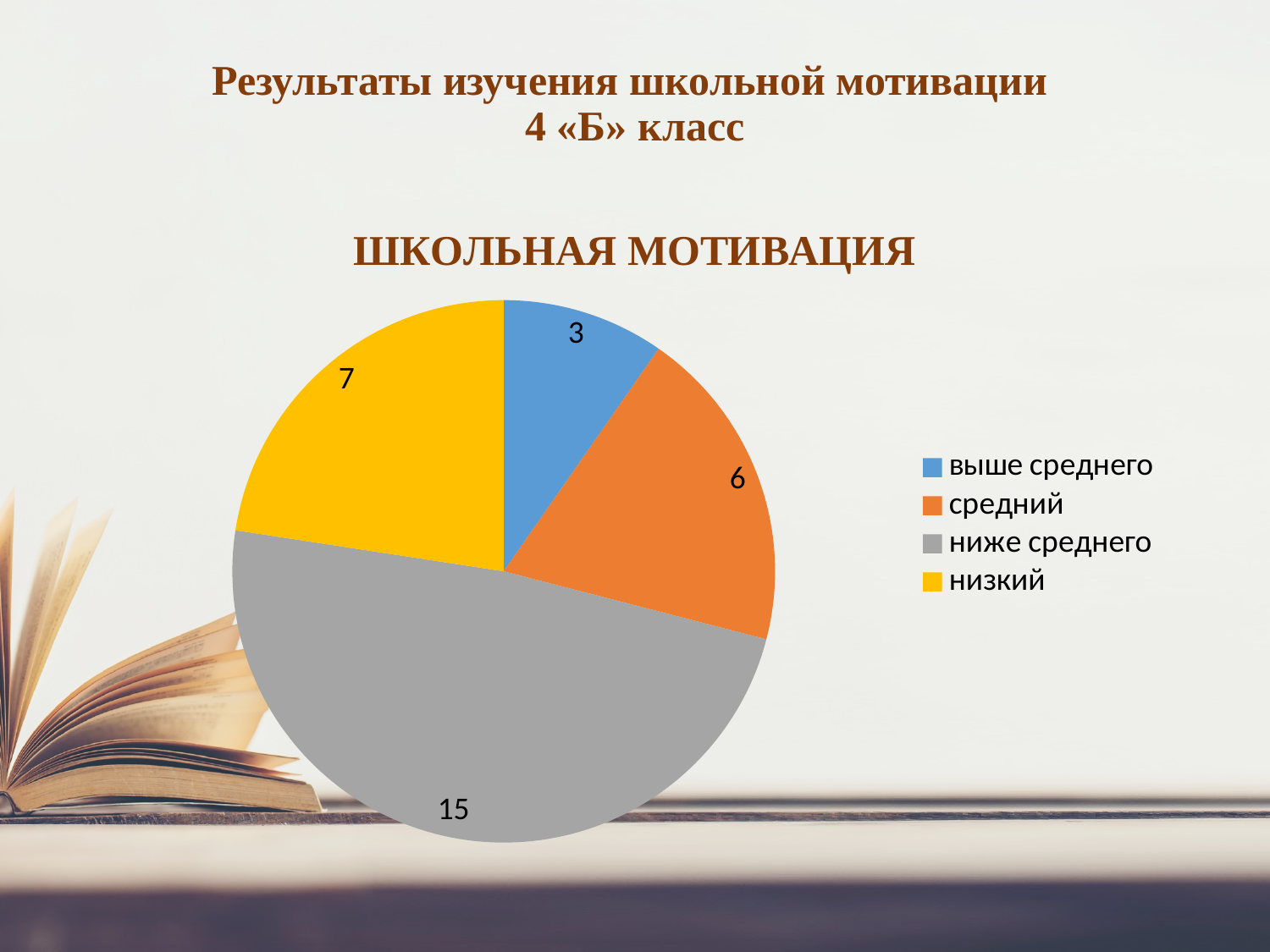
What is the title of the chart? ШКОЛЬНАЯ МОТИВАЦИЯ What is the value for the 'низкий' slice? 7 Which category has the smallest slice? выше среднего Which category has the largest slice? ниже среднего What is the total of all slices in the pie chart? 31 What is the value for the 'ниже среднего' slice? 15 Which is larger, 'средний' or 'низкий'? низкий What is the value for the 'средний' slice? 6 What is the value for the 'выше среднего' slice? 3 What type of chart is shown on the slide? pie chart How many categories does the pie chart have? 4 What is the difference between the 'ниже среднего' and 'низкий' values? 8